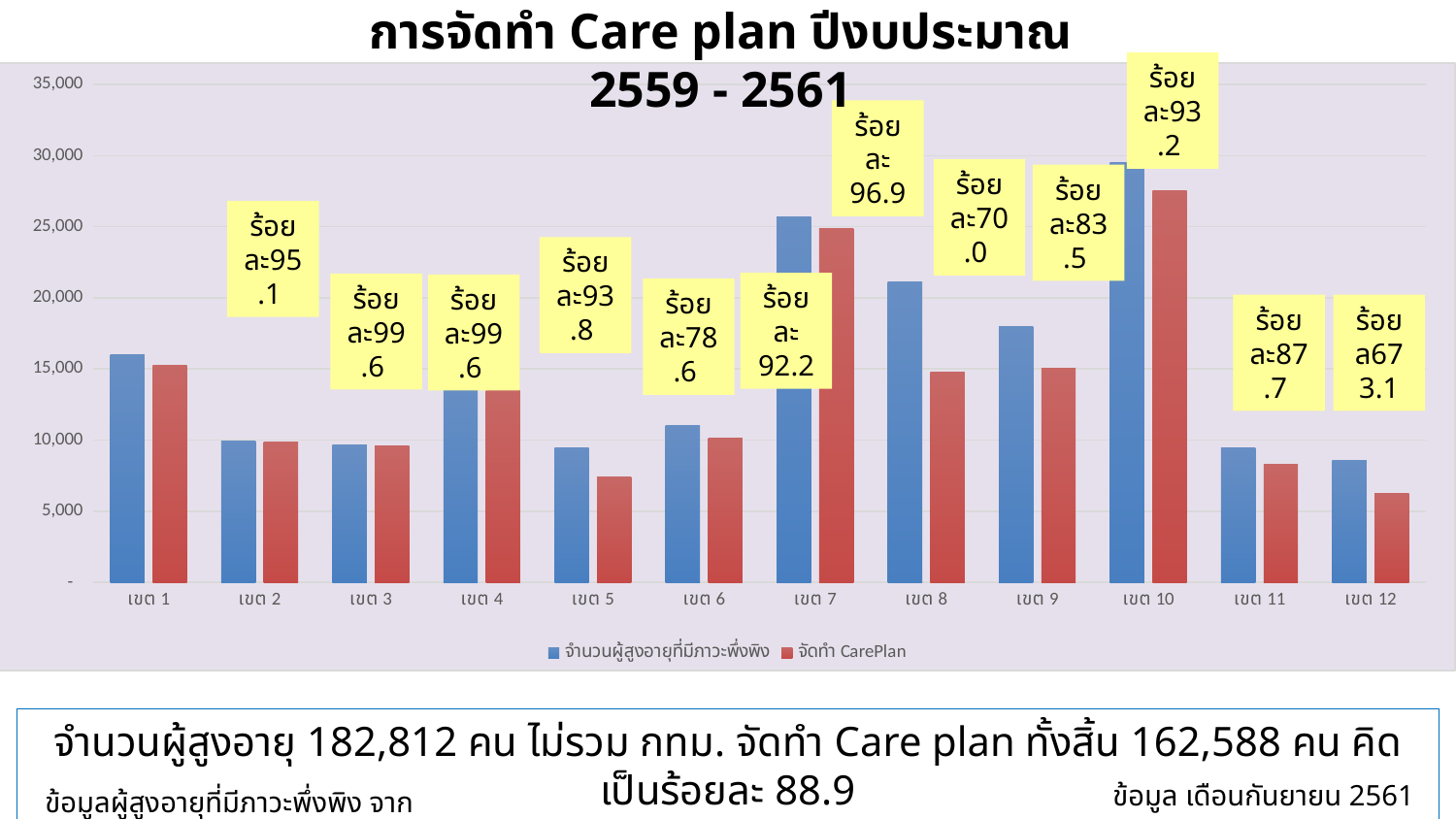
Which เขต has the lowest value for จัดทำ CarePlan? เขต 12 How many เขต categories are shown on the x axis? 12 What is the title of the chart? การจัดทำ Care plan ปีงบประมาณ 2559 - 2561 Is the value for จัดทำ CarePlan in เขต 12 greater or less than 10,000? less Which is larger: จำนวนผู้สูงอายุที่มีภาวะพึ่งพิง in เขต 8 or in เขต 9? เขต 8 Which เขต has the lowest value for จำนวนผู้สูงอายุที่มีภาวะพึ่งพิง? เขต 12 What kind of chart is shown on the slide? bar chart Is the value for จำนวนผู้สูงอายุที่มีภาวะพึ่งพิง in เขต 1 greater or less than 15,000? greater Is the value for จำนวนผู้สูงอายุที่มีภาวะพึ่งพิง in เขต 8 greater or less than 20,000? greater Which เขต has the highest value for จัดทำ CarePlan? เขต 10 How many series does the legend list? 2 Which เขต has the highest value for จำนวนผู้สูงอายุที่มีภาวะพึ่งพิง? เขต 10